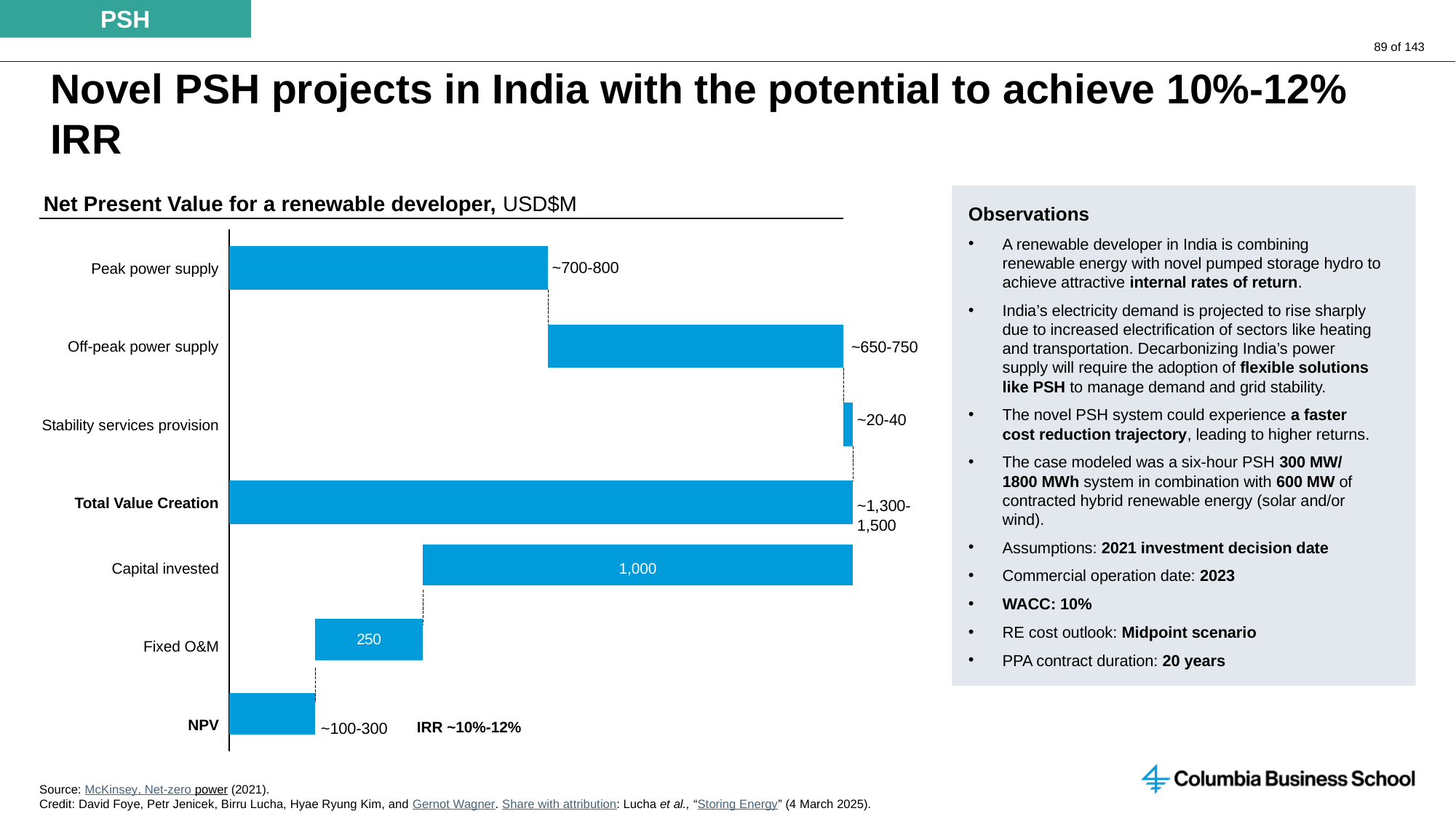
What value is shown for Peak power supply? ~700-800 What is the title of the chart? Net Present Value for a renewable developer, USD$M What value is shown for Fixed O&M? 250 What value is shown for Stability services provision? ~20-40 What value is shown for NPV? ~100-300 What is the difference between Capital invested and Fixed O&M? 750 How many categories are shown on the chart? 7 What value is shown for Off-peak power supply? ~650-750 What kind of chart is this? Bar chart (waterfall) What value is shown for Capital invested? 1,000 Which category has the smallest bar? Stability services provision What value is shown for Total Value Creation? ~1,300-1,500